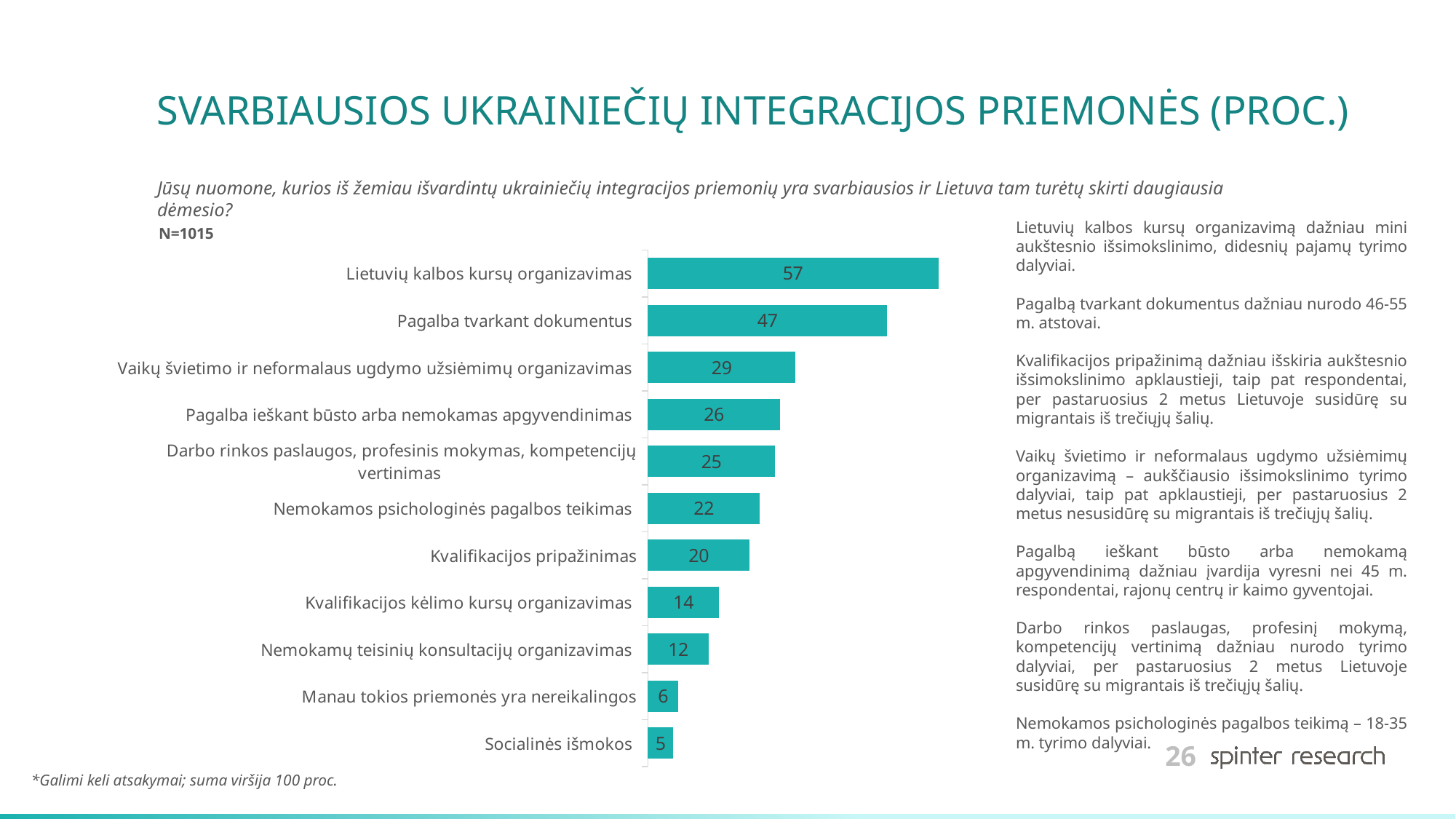
What is the value for "Lietuvių kalbos kursų organizavimas"? 57 What is the value for "Kvalifikacijos pripažinimas"? 20 What is the value for "Socialinės išmokos"? 5 What is the value for "Pagalba tvarkant dokumentus"? 47 What is the difference between the values for "Lietuvių kalbos kursų organizavimas" and "Pagalba tvarkant dokumentus"? 10 Which is larger: the value for "Nemokamos psichologinės pagalbos teikimas" or for "Kvalifikacijos kėlimo kursų organizavimas"? Nemokamos psichologinės pagalbos teikimas Which category has the highest value? Lietuvių kalbos kursų organizavimas Which category has the lowest value? Socialinės išmokos What kind of chart is shown on the slide? Bar chart What is the difference between the values for "Vaikų švietimo ir neformalaus ugdymo užsiėmimų organizavimas" and "Pagalba ieškant būsto arba nemokamas apgyvendinimas"? 3 How many categories are shown in the chart? 11 What sample size (N) is stated on the slide for the chart? N=1015